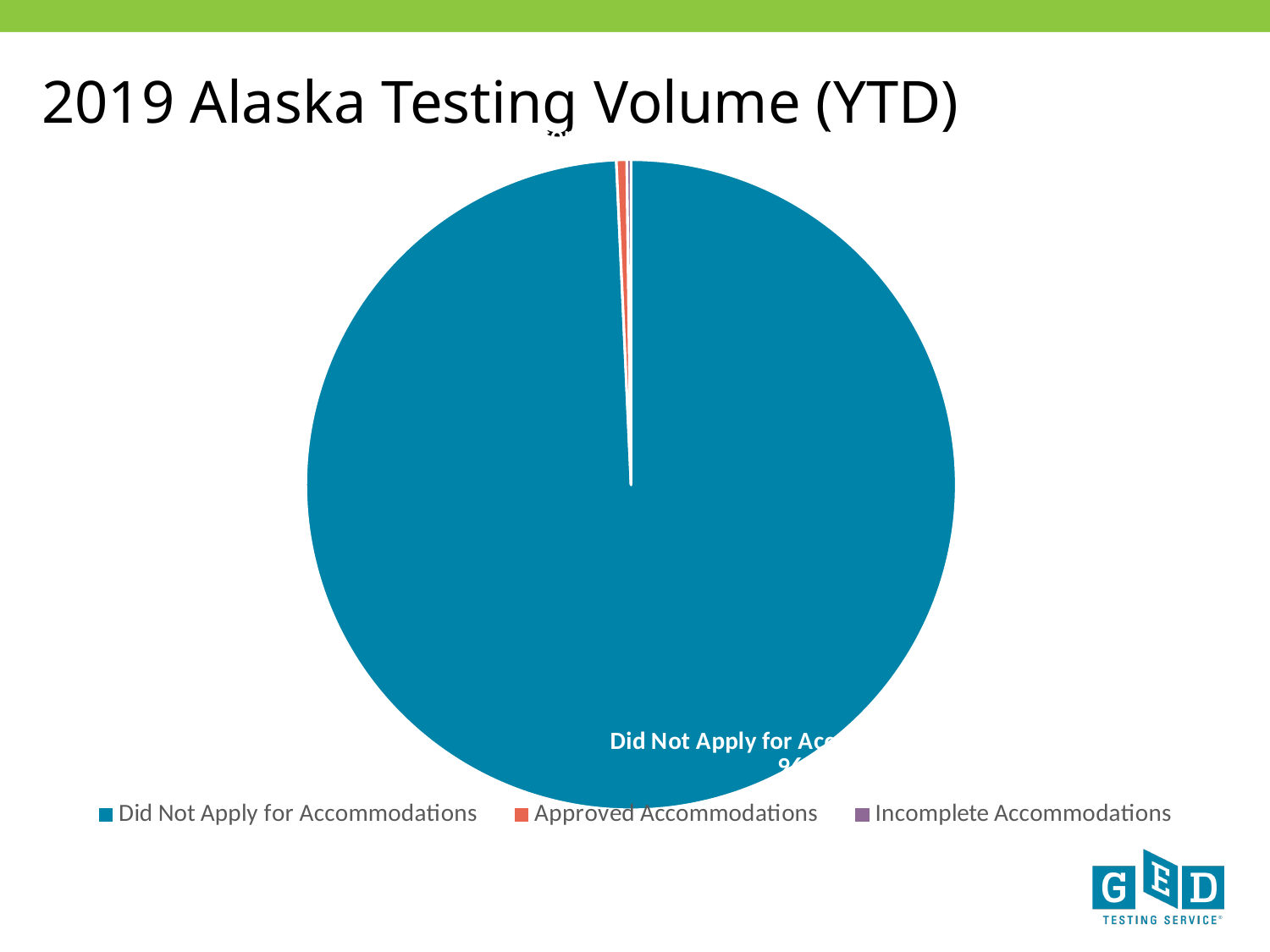
Which is larger in the pie chart: Did Not Apply for Accommodations or Approved Accommodations? Did Not Apply for Accommodations What kind of chart is shown on the slide? pie chart Which colour represents Approved Accommodations in the pie chart legend? orange How many categories does the legend of the pie chart list? 3 Is the share of the pie for Did Not Apply for Accommodations greater or less than 50%? greater Which category has the largest slice of the pie chart? Did Not Apply for Accommodations What is the title of the slide containing the pie chart? 2019 Alaska Testing Volume (YTD) Is the share of the pie for Approved Accommodations greater or less than 25%? less